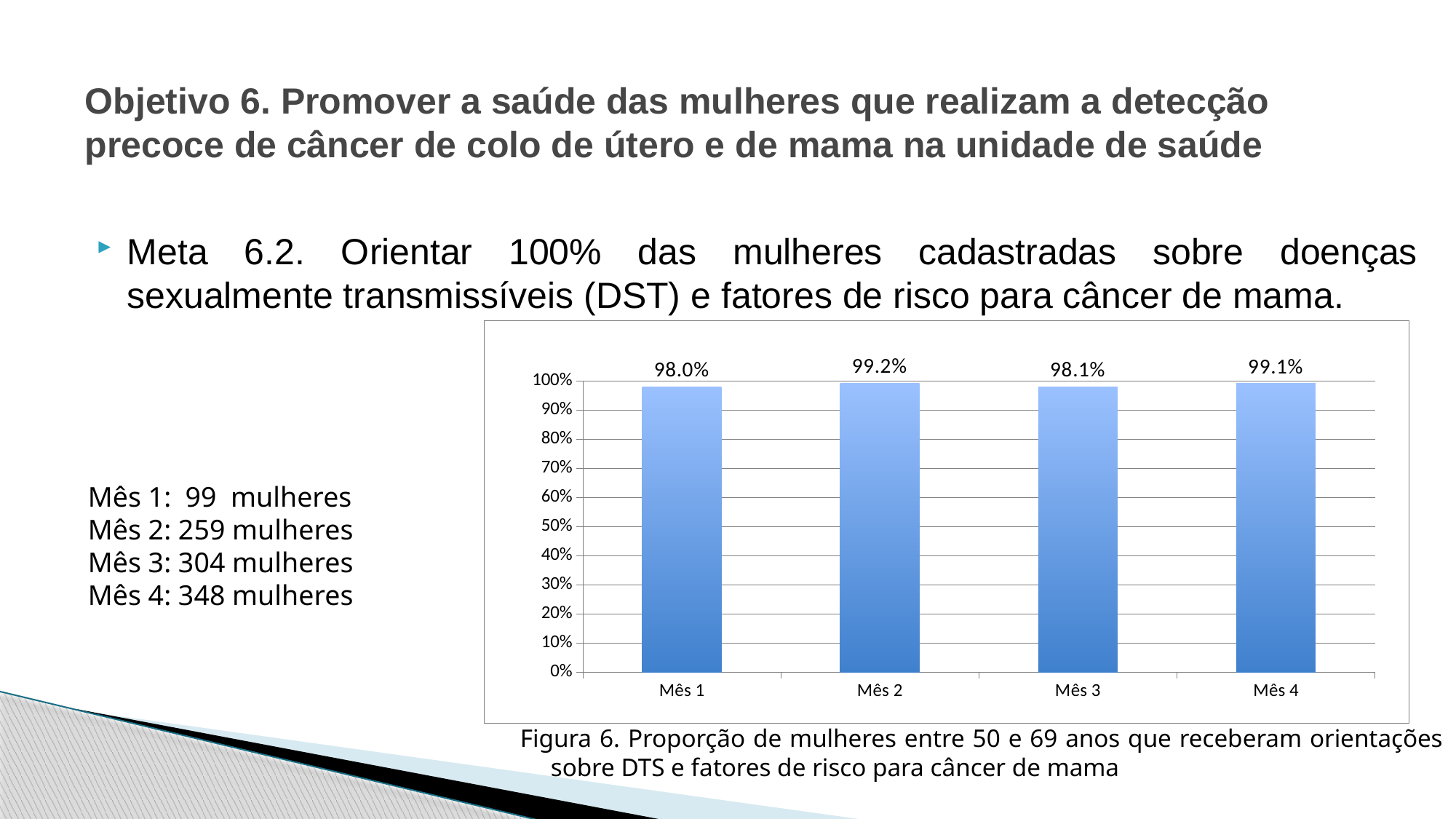
Which month has the lowest value? Mês 1 Which month has the highest value? Mês 2 What is the highest tick value shown on the y axis of the chart? 100% What kind of chart is shown on the slide? bar chart What is the value for Mês 2? 99.2% What is the value for Mês 1? 98.0% What is the difference between the values for Mês 4 and Mês 3? 1.0% What is the value for Mês 4? 99.1% What is the value for Mês 3? 98.1% What is the difference between the values for Mês 2 and Mês 1? 1.2% How many months are shown on the x axis of the chart? 4 Which is larger, the value for Mês 2 or the value for Mês 3? Mês 2